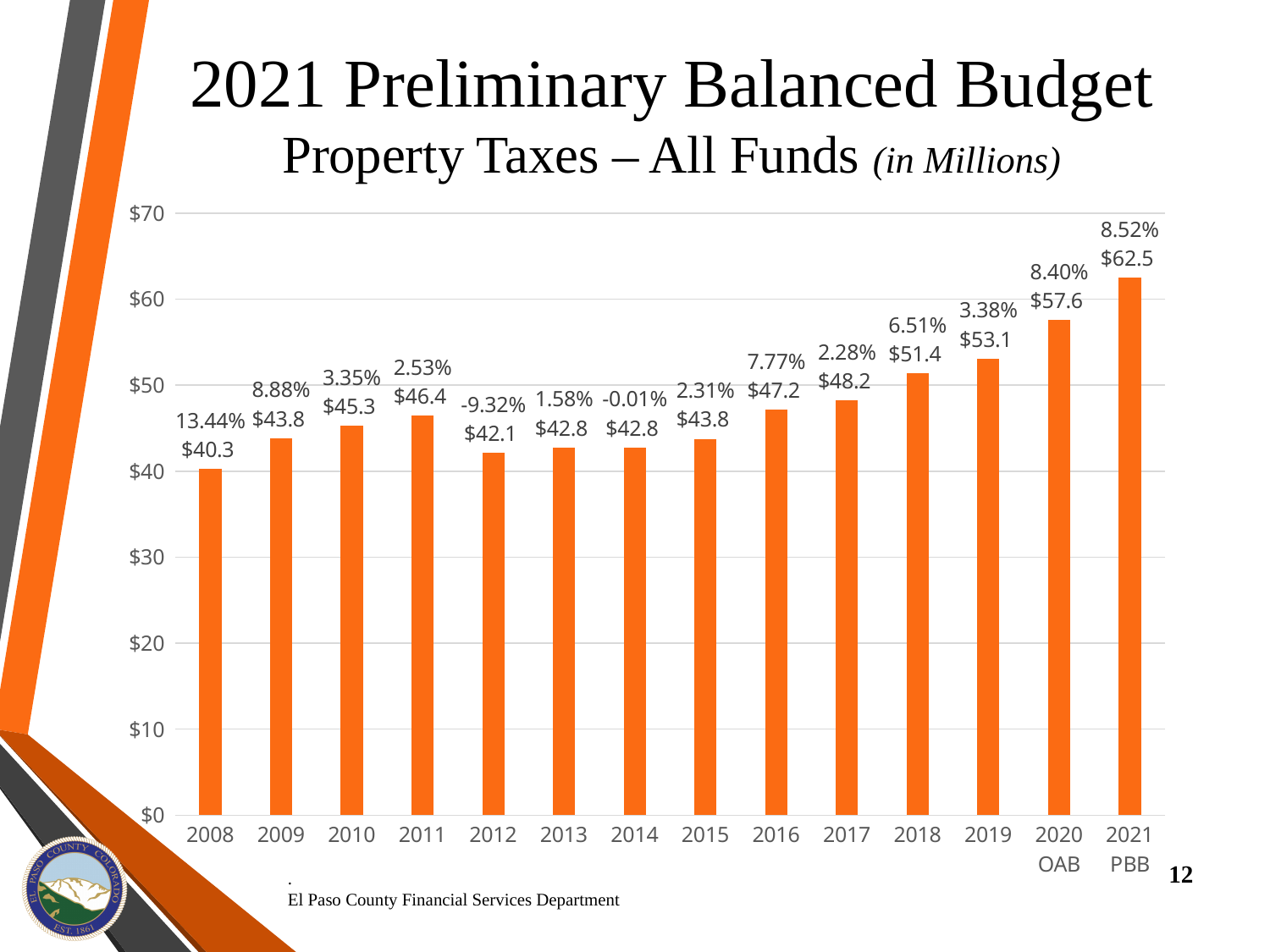
Which is larger, the value for 2011 or the value for 2015? 2011 What is the difference between the 2021 PBB value and the 2020 OAB value? $4.9 What kind of chart is shown on the slide? Bar chart What percentage change is shown above the 2012 bar? -9.32% Is the value for 2019 greater or less than $50? greater What is the property tax value for 2016? $47.2 Which year has the lowest property tax value? 2008 What is the title of the chart? 2021 Preliminary Balanced Budget Property Taxes – All Funds (in Millions) Do the values generally rise or fall from 2015 to 2021 PBB? Rise How many years (bars) are shown on the chart? 14 Which year has the highest property tax value? 2021 PBB What is the property tax value for 2021 PBB? $62.5